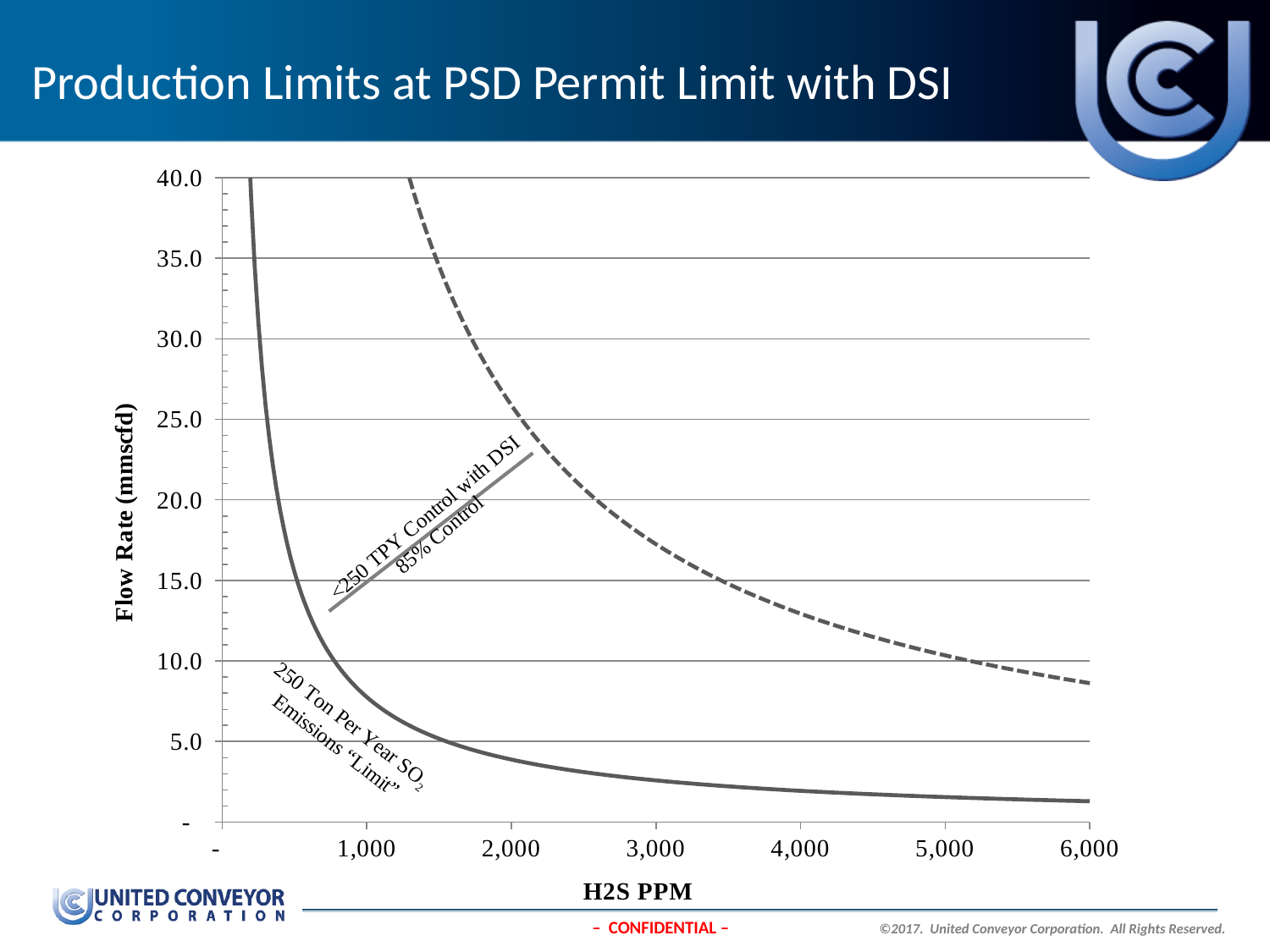
As H2S PPM increases, does the dashed '<250 TPY Control with DSI 85% Control' curve rise or fall? fall At 3,000 H2S PPM, which curve shows the higher flow rate: the solid '250 Ton Per Year SO2 Emissions Limit' curve or the dashed '<250 TPY Control with DSI' curve? the dashed '<250 TPY Control with DSI' curve How many curves are plotted on the chart? 2 Is the flow rate on the dashed '<250 TPY Control with DSI' curve at 3,000 H2S PPM greater or less than 15.0? greater What is the label of the x axis? H2S PPM Is the flow rate on the dashed '<250 TPY Control with DSI' curve at 6,000 H2S PPM greater or less than 10.0? less Is the flow rate on the solid '250 Ton Per Year SO2 Emissions Limit' curve at 1,000 H2S PPM greater or less than 10.0? less What kind of chart is shown on the slide? line chart What is the title of the chart on the slide? Production Limits at PSD Permit Limit with DSI As H2S PPM increases along the x axis, does the flow rate on the solid '250 Ton Per Year SO2 Emissions Limit' curve rise or fall? fall